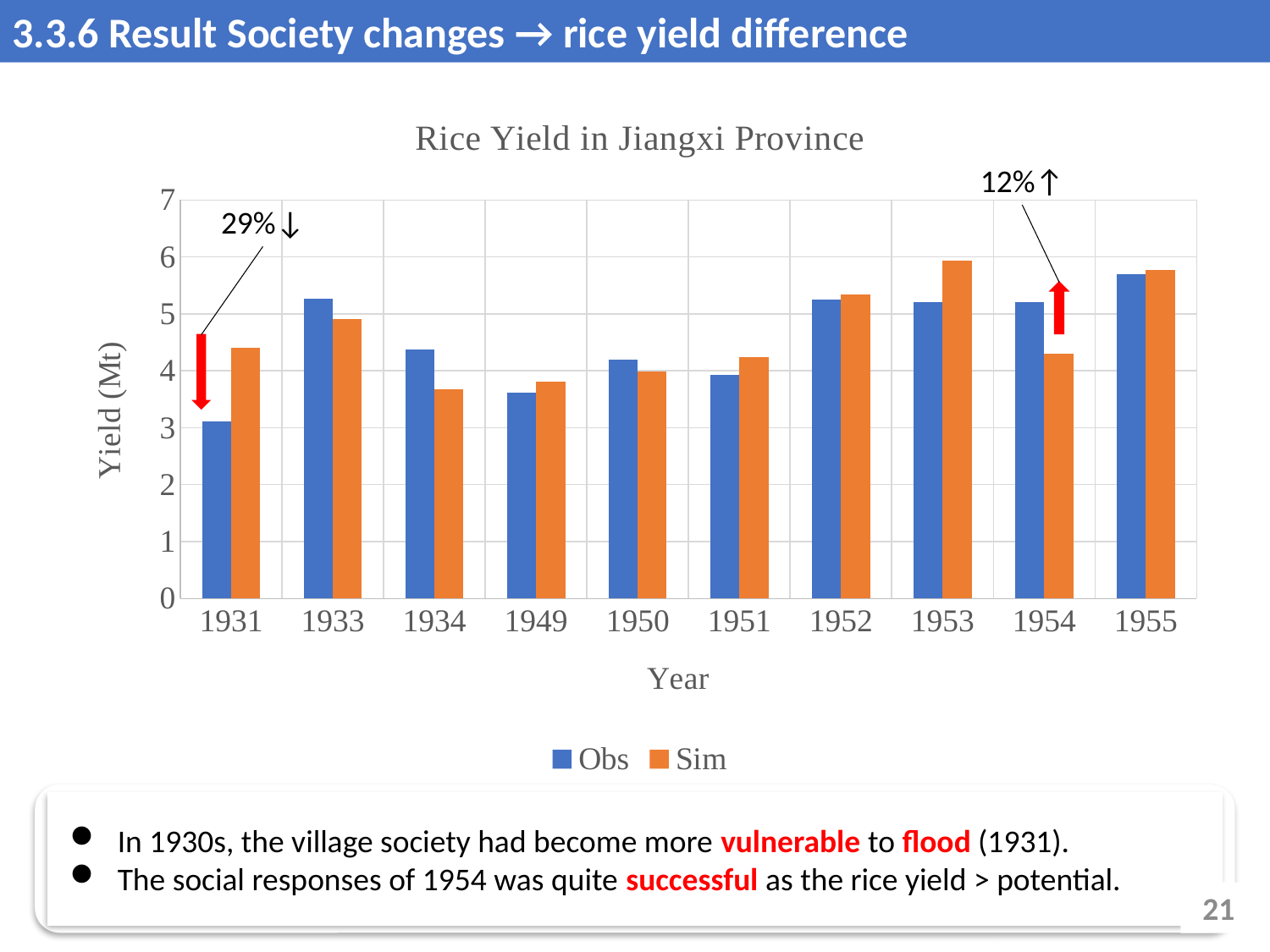
How many years are shown on the x axis? 10 Is the Obs value for 1931 greater or less than 4? less Which year has the highest Obs value? 1955 Which year has the lowest Obs value? 1931 Which year has the highest Sim value? 1953 In 1954, which is larger, the Obs value or the Sim value? Obs In 1931, which is larger, the Obs value or the Sim value? Sim What percentage change is annotated above the 1954 bars? 12%↑ Is the Sim value for 1953 greater or less than 5? greater How many series does the legend list? 2 What kind of chart is shown on the slide? bar chart What is the title of the chart? Rice Yield in Jiangxi Province